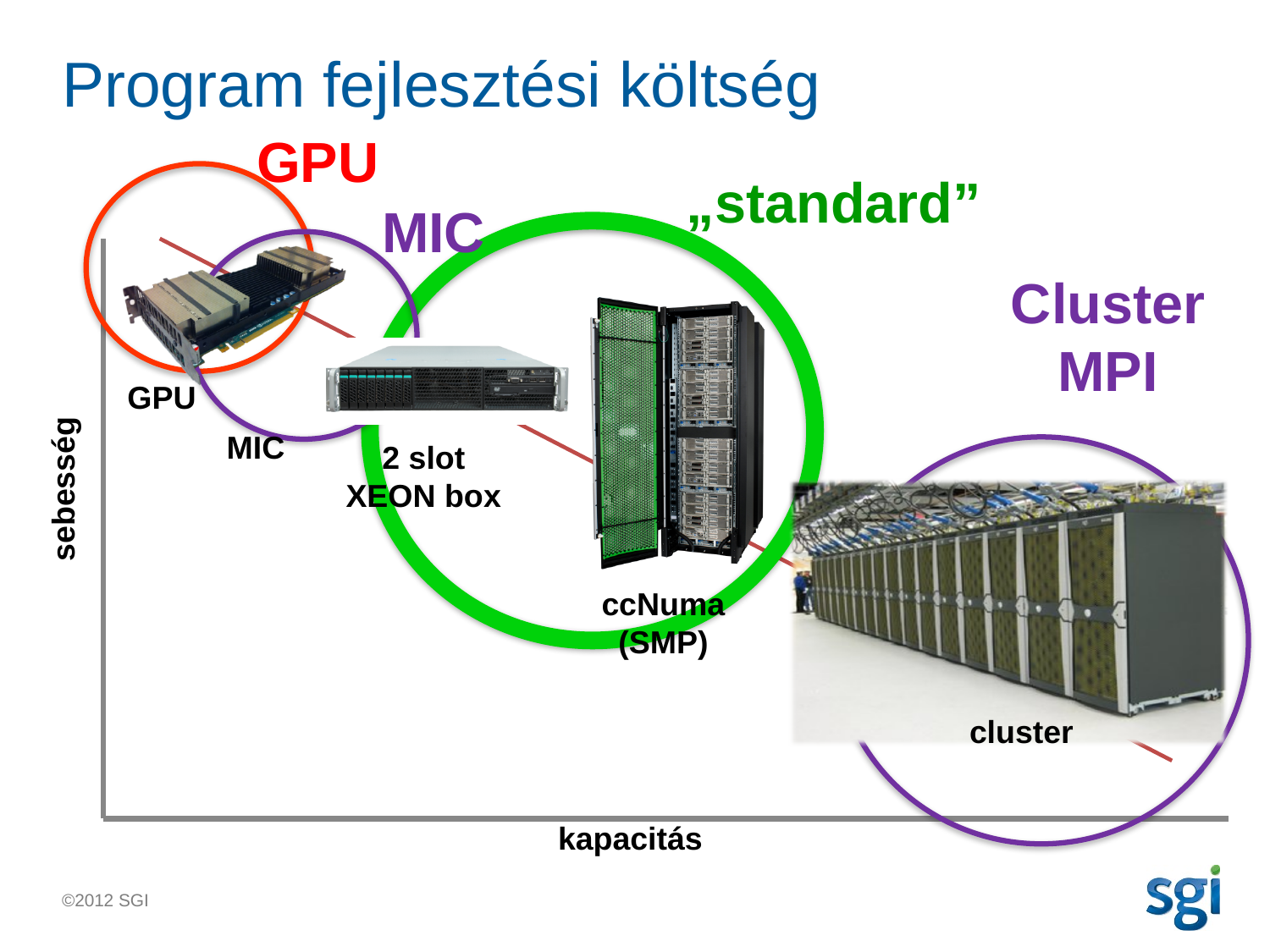
What are the labels of the x axis and the y axis of the chart? kapacitás (x), sebesség (y) Which item is placed lowest on the sebesség axis? cluster How many hardware categories are placed along the chart (GPU, MIC, 2 slot XEON box, ccNuma (SMP), cluster)? 5 What is the title of the slide containing the chart? Program fejlesztési költség Along the kapacitás axis from left to right, does the sebesség position of the items rise or fall? fall Which is placed further right on the kapacitás axis, the 2 slot XEON box or the cluster? cluster Which is placed higher on the sebesség axis, GPU or ccNuma (SMP)? GPU Which item is placed highest on the sebesség axis? GPU